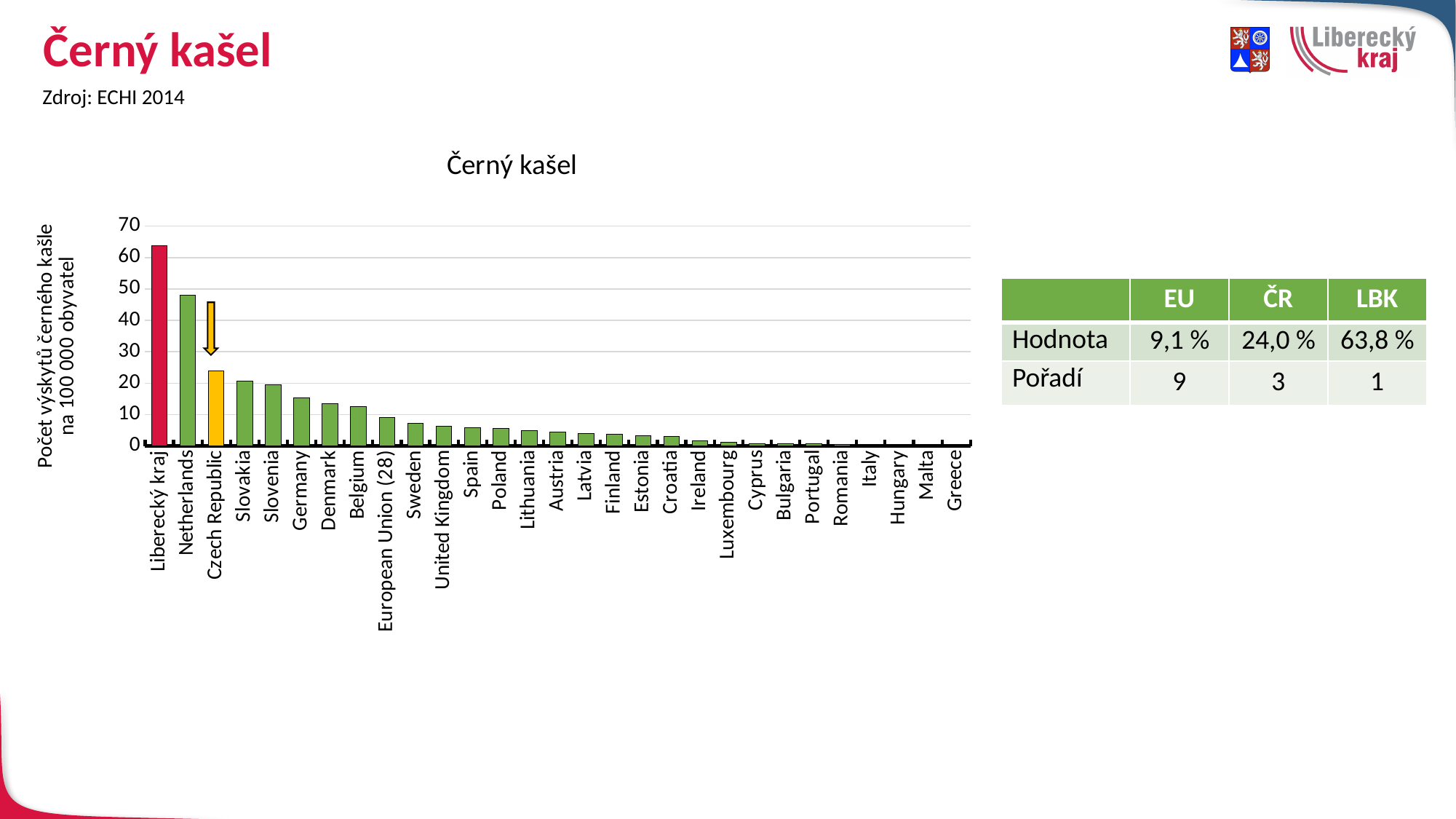
Do the values rise or fall moving from left to right along the x axis? fall Is the value for Netherlands greater or less than 40? greater Which category has the highest value in the chart? Liberecký kraj Which has a larger value, Netherlands or Czech Republic? Netherlands What is the title of the chart? Černý kašel Is the value for Sweden greater or less than 10? less How many categories are plotted on the x axis of the chart? 29 What kind of chart is shown on the slide? bar chart What colour is the bar for Liberecký kraj? red Is the value for Liberecký kraj greater or less than 60? greater